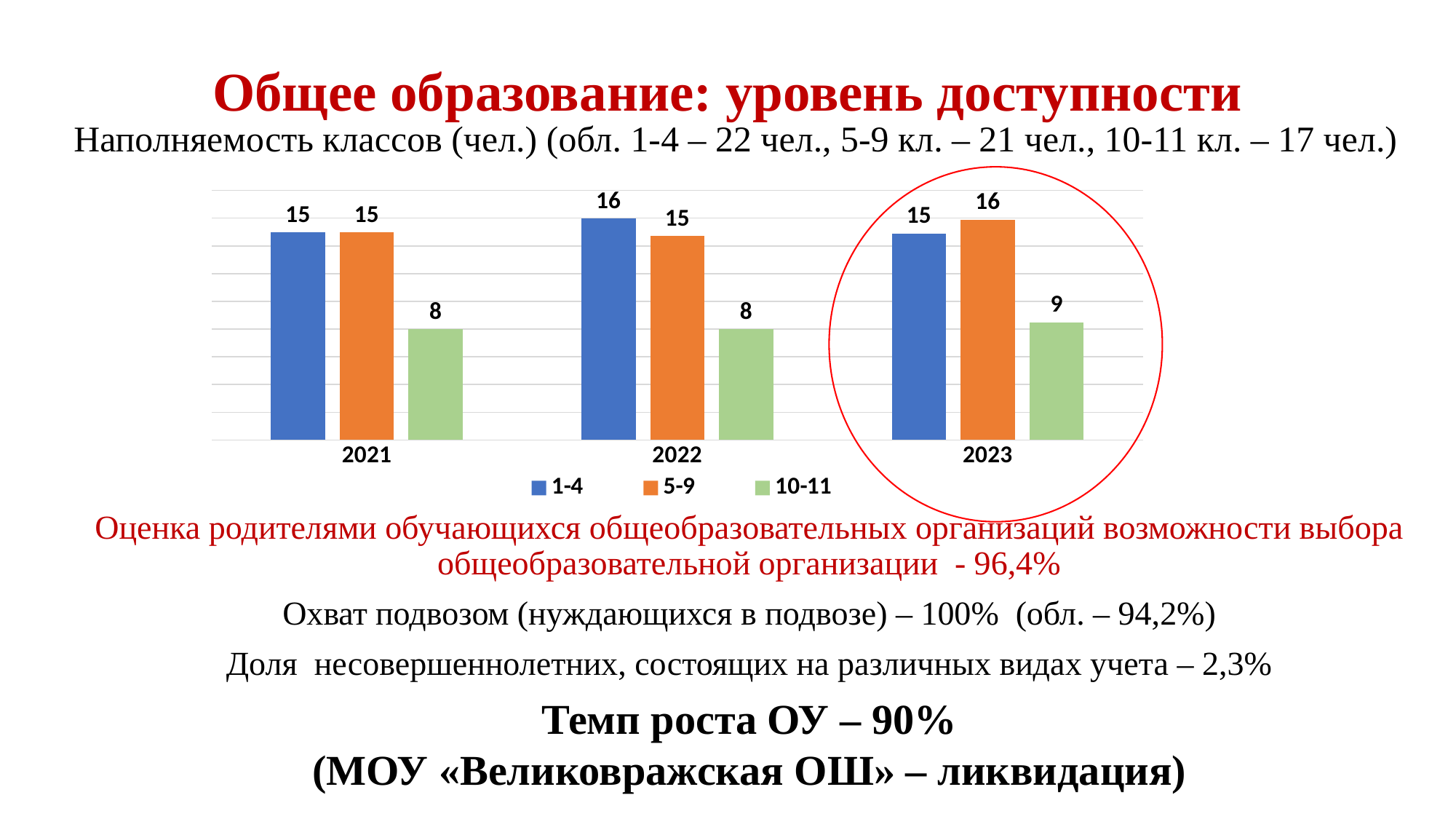
What is the value for the 10-11 series in 2023? 9 What is the difference between the 5-9 value and the 10-11 value in 2023? 7 What is the value for the 1-4 series in 2022? 16 Does the value for the 10-11 series rise or fall from 2022 to 2023? rise In 2023, which series has the highest value? 5-9 How many year categories are shown on the x axis of the chart? 3 Which year on the chart is circled in red? 2023 What is the value for the 5-9 series in 2021? 15 What type of chart is shown on the slide? bar chart In 2022, which series has the lowest value? 10-11 How many series does the chart legend list? 3 Which is larger in 2022: the value for 1-4 or the value for 5-9? 1-4